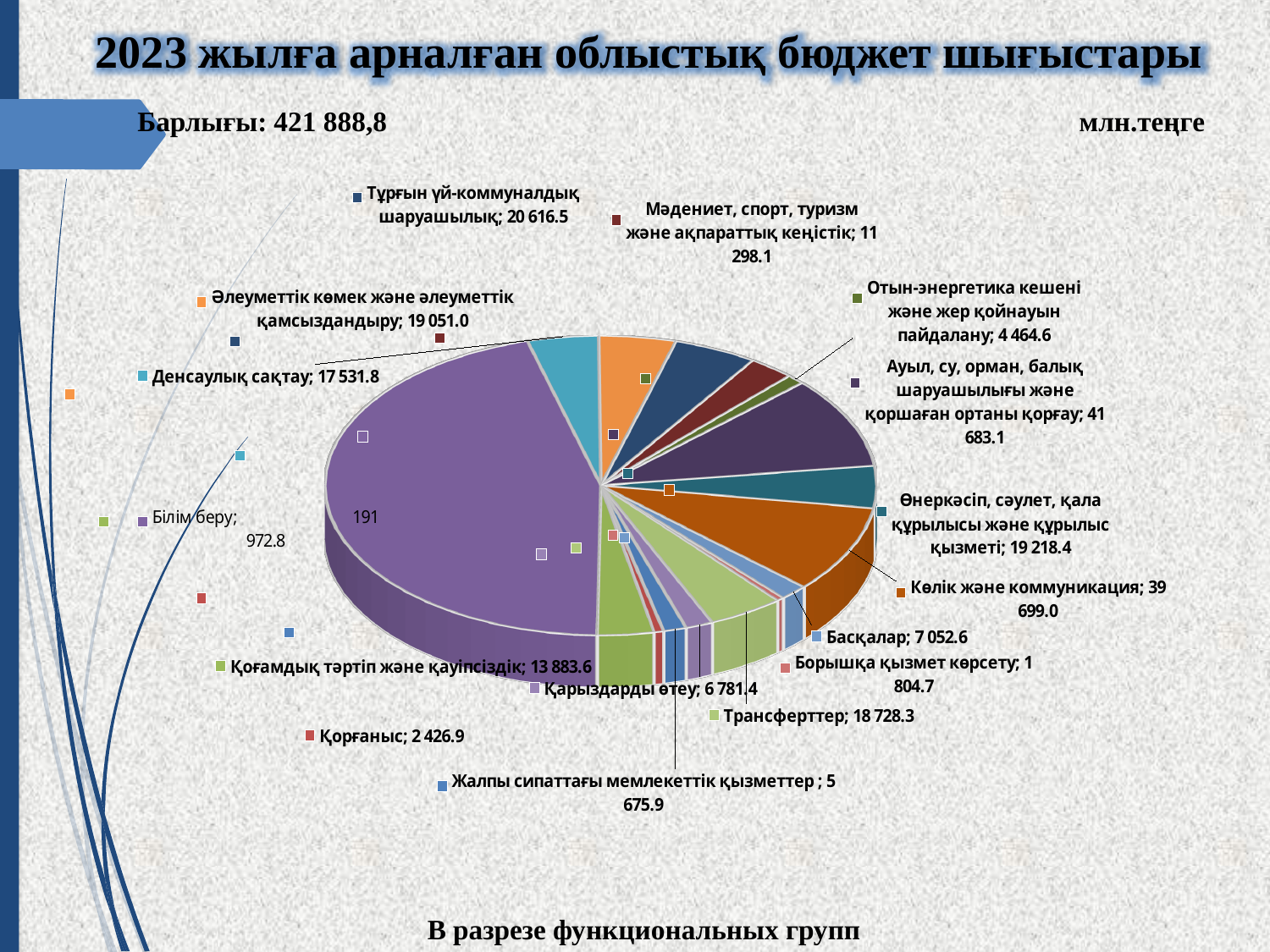
Which category has the smallest value? Борышқа қызмет көрсету How many categories (slices) does the pie chart have? 16 What is the difference between Көлік және коммуникация and Өнеркәсіп, сәулет, қала құрылысы және құрылыс қызметі? 20 480.6 What is the value for Қорғаныс? 2 426.9 What total amount (Барлығы) is stated on the slide? 421 888,8 What unit is stated for the values on the slide? млн.теңге Which category has the largest value? Білім беру What type of chart is shown on the slide? Pie chart What is the value for Денсаулық сақтау? 17 531.8 Which is larger: Трансферттер or Денсаулық сақтау? Трансферттер What is the value for Білім беру? 191 972.8 What is the value for Көлік және коммуникация? 39 699.0